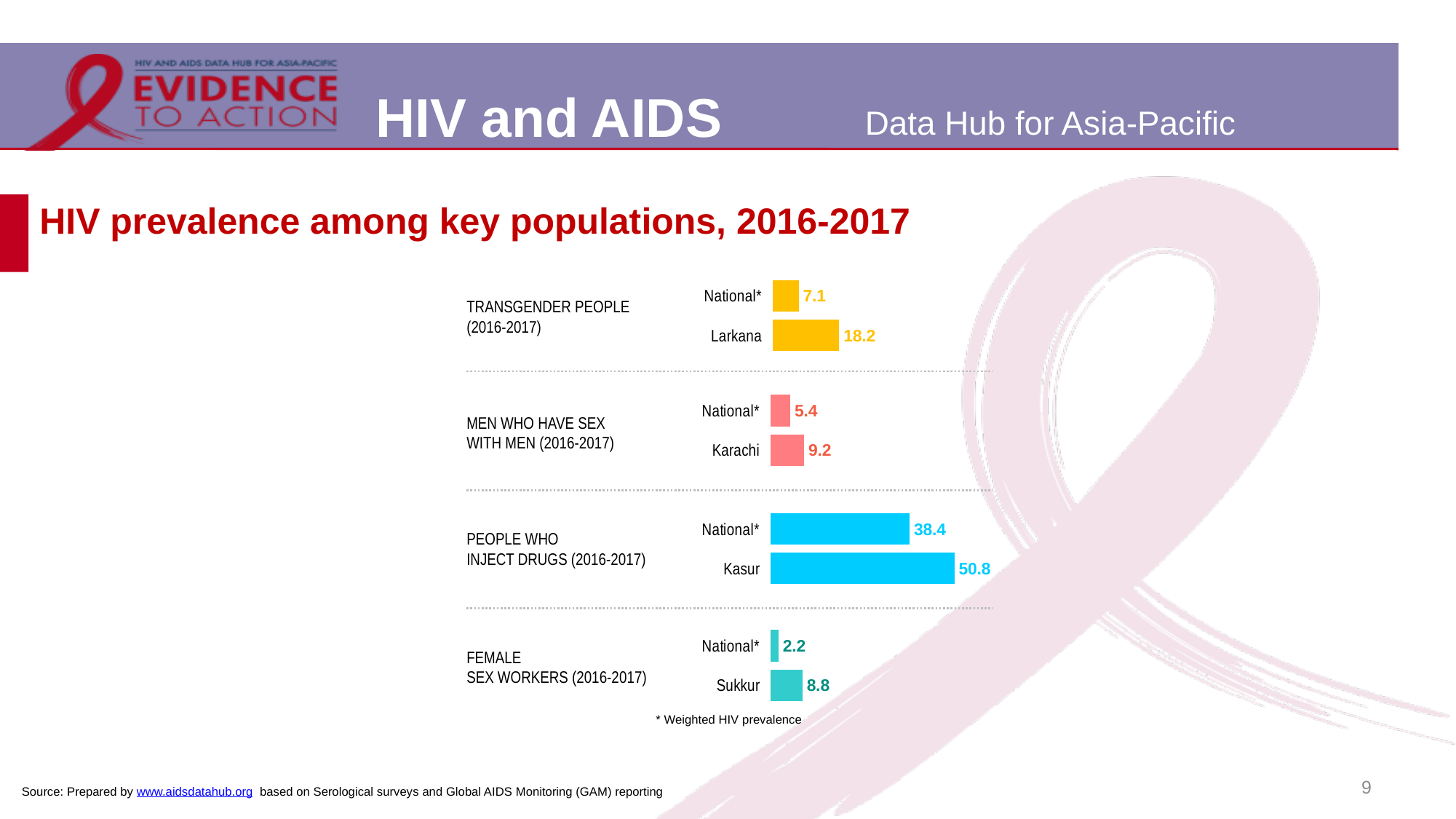
What is the HIV prevalence among female sex workers in Sukkur? 8.8 How many bars are plotted on the chart in total? 8 What is the HIV prevalence for transgender people in Larkana? 18.2 What is the HIV prevalence among people who inject drugs in Kasur? 50.8 What does the asterisk next to 'National' indicate? Weighted HIV prevalence Which is larger: the Karachi value for men who have sex with men or the Sukkur value for female sex workers? Karachi What type of chart is shown on the slide? Bar chart Which bar shows the highest HIV prevalence on the chart? Kasur (people who inject drugs) What is the difference between the Kasur and National* values for people who inject drugs? 12.4 What is the national weighted HIV prevalence among men who have sex with men? 5.4 Which bar shows the lowest HIV prevalence on the chart? National* (female sex workers) What is the difference between the Larkana and National* values for transgender people? 11.1